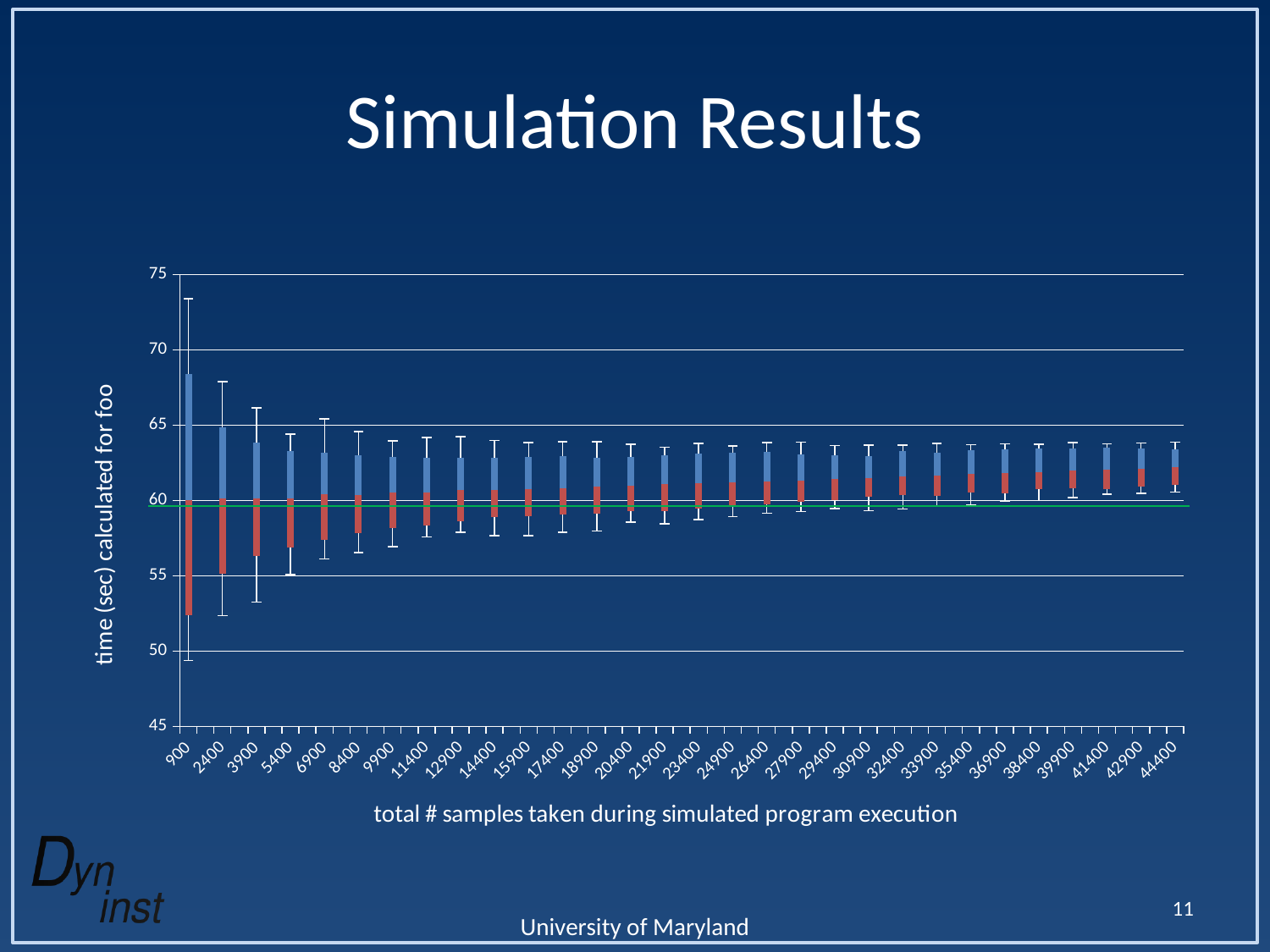
What is the label of the x axis? total # samples taken during simulated program execution What is the title of the chart? Simulation Results Is the bottom of the lower whisker for 900 samples greater or less than 50? less What kind of chart is shown on the slide? box-and-whisker chart Does the spread (whisker range) of the calculated time widen or narrow as the number of samples increases along the x axis? narrow How many x-axis categories (sample counts) are plotted on the chart? 30 Which x-axis category has the widest whisker range, 900 or 44400? 900 Is the top of the upper whisker for 900 samples greater or less than 70? greater What is the lowest value shown on the y axis? 45 Is the bottom of the lower whisker for 2400 samples greater or less than 55? less